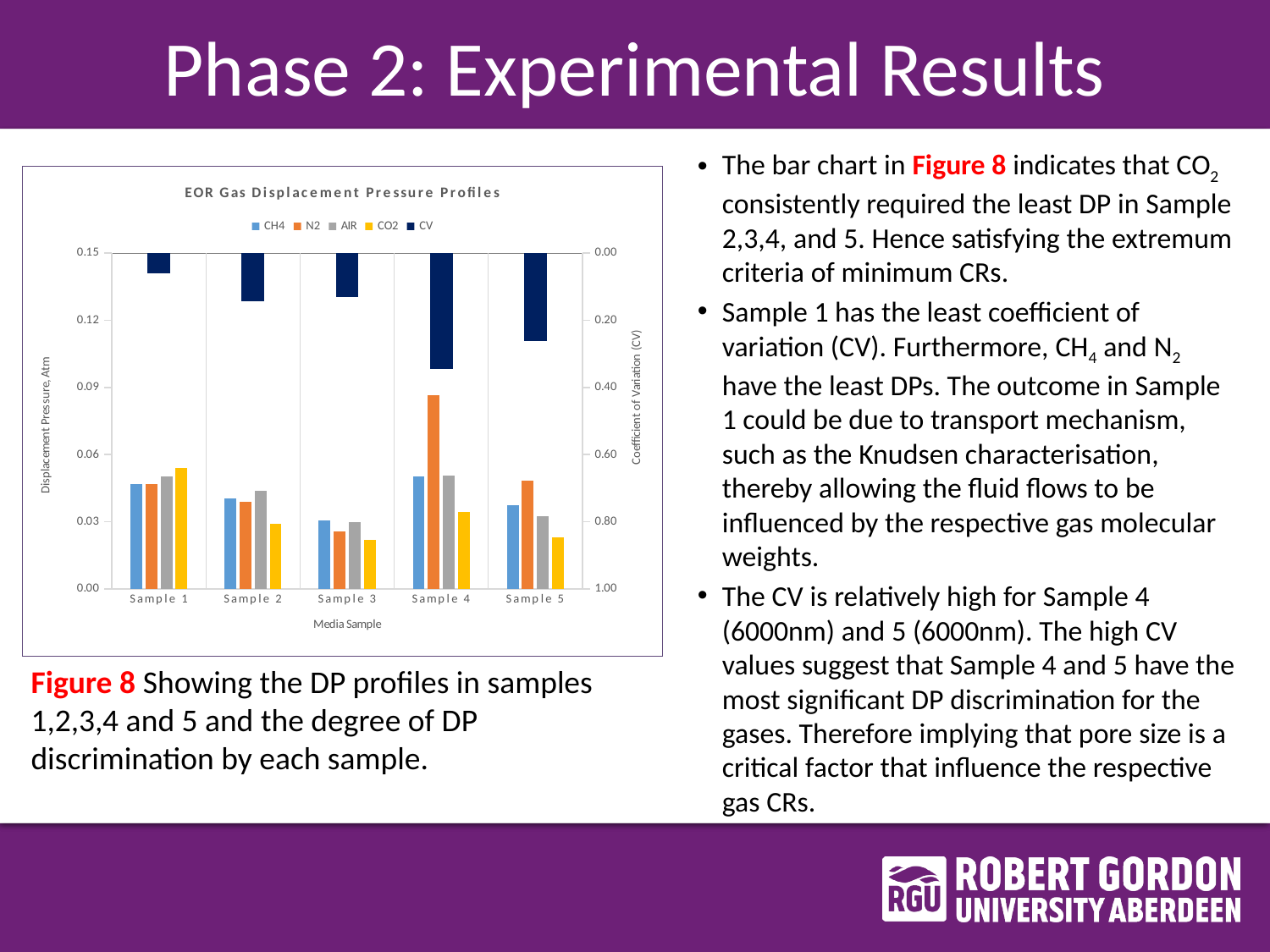
Is the CO2 displacement pressure for Sample 1 greater or less than 0.03? greater Is the CO2 displacement pressure for Sample 3 greater or less than 0.03? less What is the title of the chart? EOR Gas Displacement Pressure Profiles What is the label of the left vertical axis of the chart? Displacement Pressure, Atm Which sample has the highest N2 displacement pressure bar? Sample 4 In Sample 4, which gas has the lowest displacement pressure bar? CO2 How many series does the legend of the chart list? 5 Is the N2 displacement pressure for Sample 4 greater or less than 0.06? greater How many media samples are shown along the x axis of the chart? 5 In Sample 4, which is larger: the N2 bar or the CO2 bar? N2 What type of chart is shown on the slide? bar chart Which sample has the longest CV bar? Sample 4